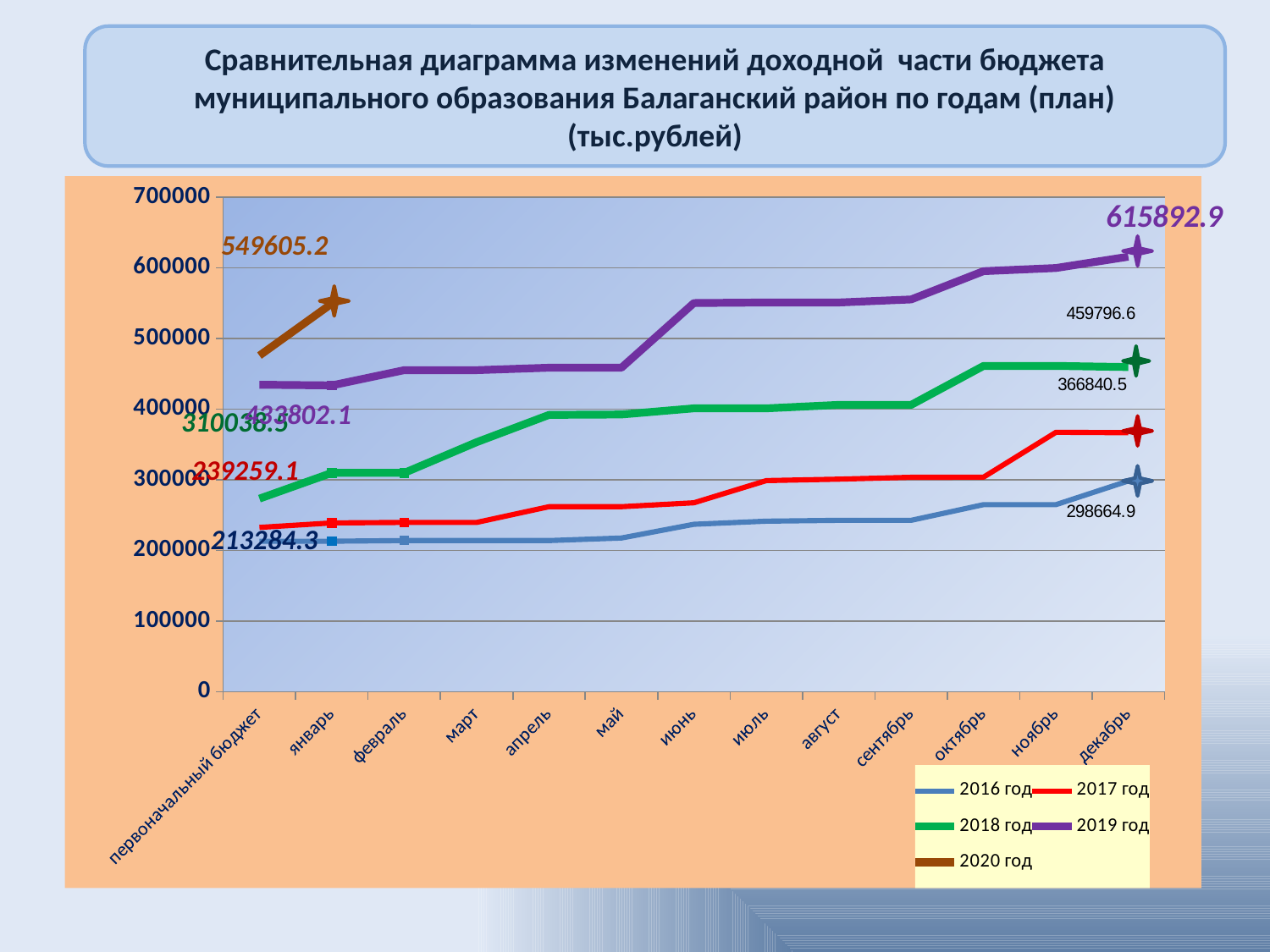
How many categories are on the x axis? 13 Does the 2019 год series rise or fall from январь to декабрь? rise Is the value for 2019 год in июнь greater or less than 500000? greater How many series does the legend list? 5 Which is larger in декабрь: the value for 2018 год or for 2017 год? 2018 год What is the value for 2017 год in январь? 239259.1 Which series has the highest value in декабрь? 2019 год What kind of chart is shown on the slide? line chart What is the value for 2020 год in январь? 549605.2 What is the difference between the 2019 год and 2018 год values in декабрь? 156096.3 What is the value for 2016 год in декабрь? 298664.9 What is the value for 2019 год in декабрь? 615892.9